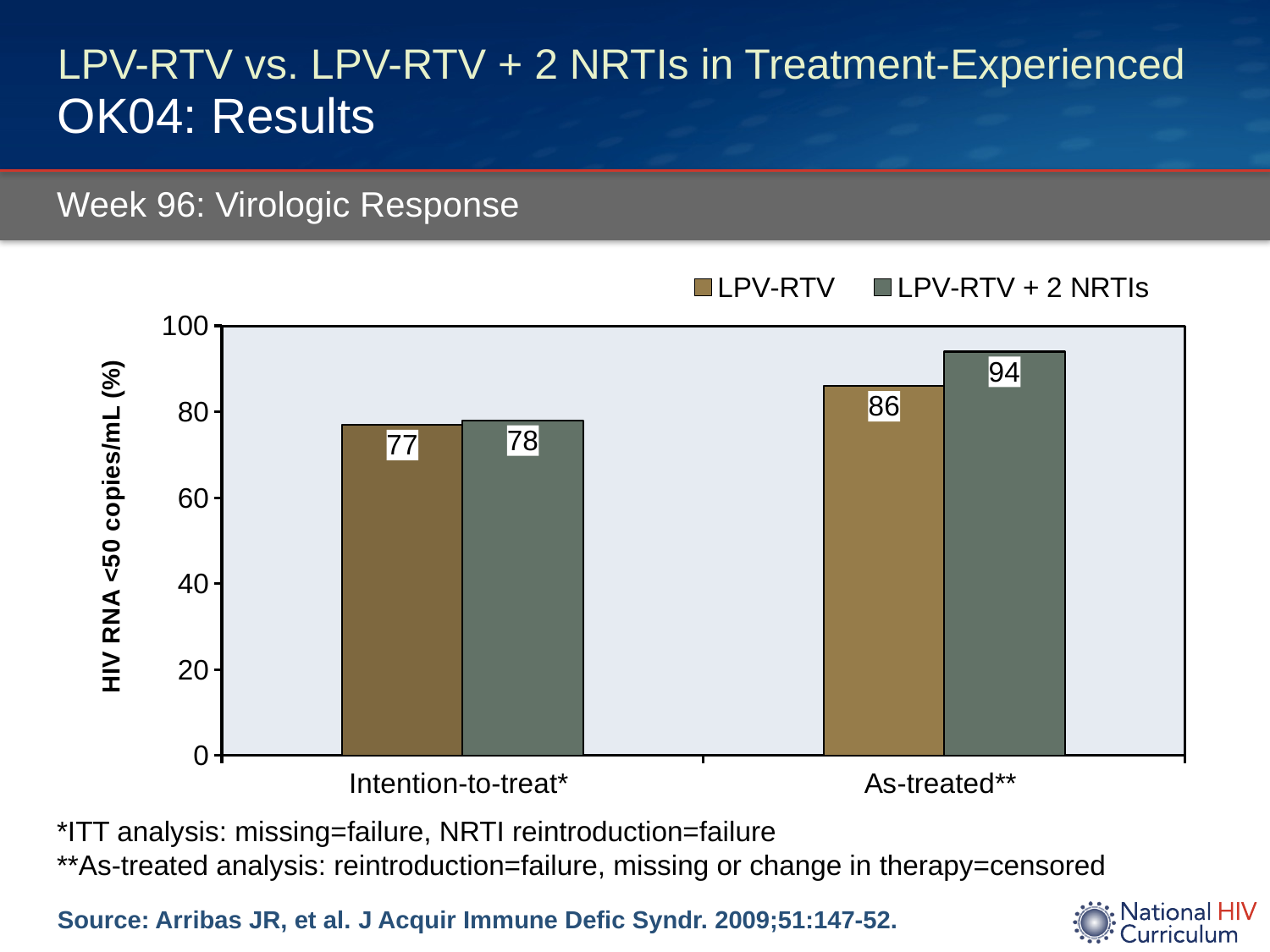
What is the difference between the LPV-RTV value in the As-treated** group and the LPV-RTV value in the Intention-to-treat* group? 9 What is the value for LPV-RTV + 2 NRTIs in the As-treated** group? 94 What is the value for LPV-RTV + 2 NRTIs in the Intention-to-treat* group? 78 What kind of chart is shown on the slide? Bar chart Which is larger: the LPV-RTV + 2 NRTIs value in the As-treated** group or the LPV-RTV + 2 NRTIs value in the Intention-to-treat* group? As-treated** What is the difference between the LPV-RTV + 2 NRTIs and LPV-RTV values in the As-treated** group? 8 How many categories are shown on the x axis? 2 What is the value for LPV-RTV in the As-treated** group? 86 What is the value for LPV-RTV in the Intention-to-treat* group? 77 Which bar has the lowest value on the chart? LPV-RTV, Intention-to-treat* Which bar has the highest value on the chart? LPV-RTV + 2 NRTIs, As-treated** How many series does the legend list? 2